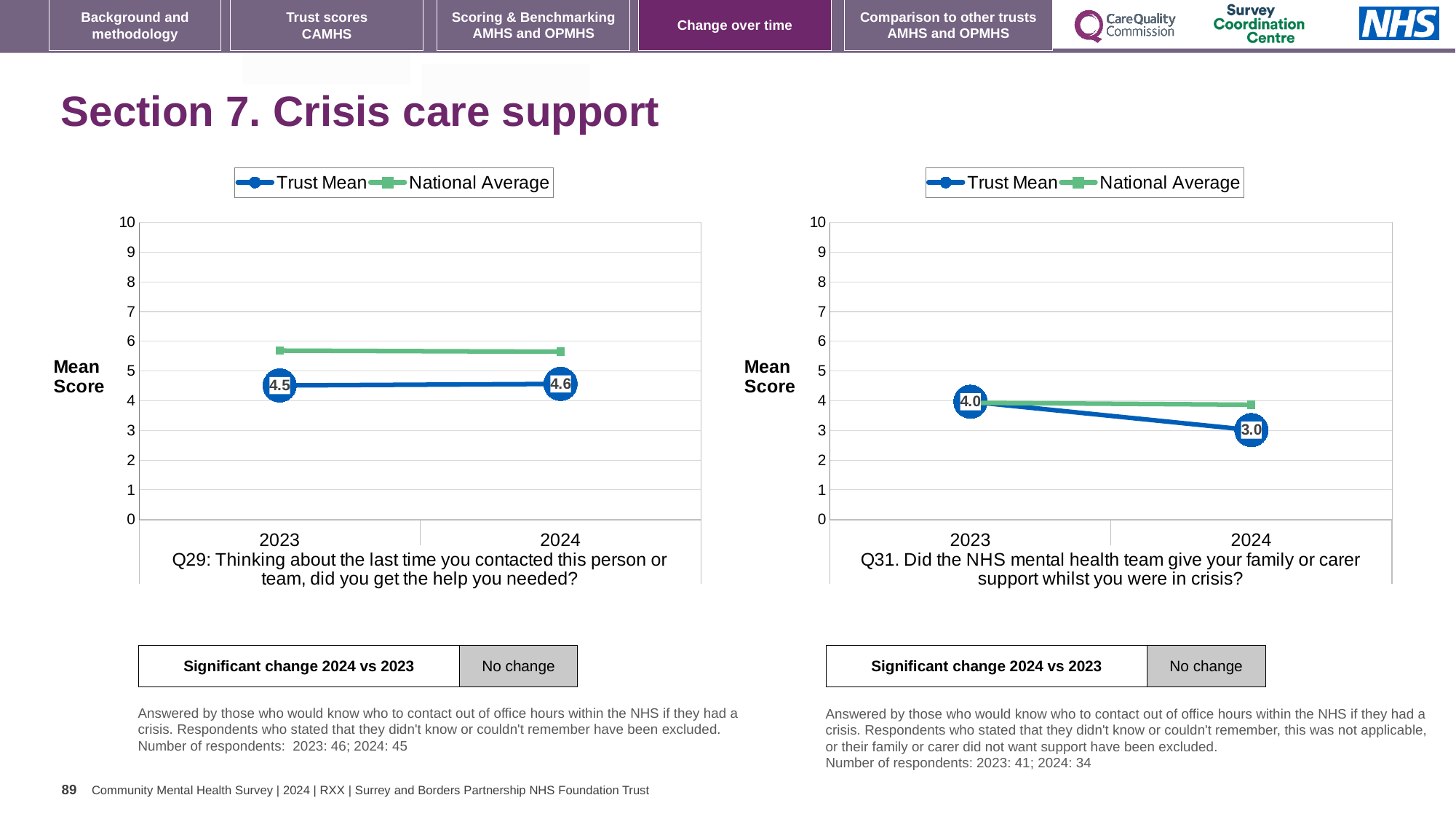
What kind of chart is the Q31 chart (right)? line chart In the Q31 chart (right), which series is higher in 2024, Trust Mean or National Average? National Average In the Q31 chart (right), what is the Trust Mean score for 2023? 4.0 In the Q29 chart (left), does the Trust Mean rise or fall from 2023 to 2024? rise How many series does the legend of the Q29 chart (left) list? 2 In the Q29 chart (left), which series is higher in 2024, Trust Mean or National Average? National Average In the Q31 chart (right), what is the Trust Mean score for 2024? 3.0 In the Q29 chart (left), what is the Trust Mean score for 2023? 4.5 In the Q29 chart (left), what is the Trust Mean score for 2024? 4.6 In the Q31 chart (right), does the Trust Mean rise or fall from 2023 to 2024? fall In the Q31 chart (right), by how much did the Trust Mean score fall from 2023 to 2024? 1.0 In the Q29 chart (left), is the National Average for 2023 greater or less than 5? greater